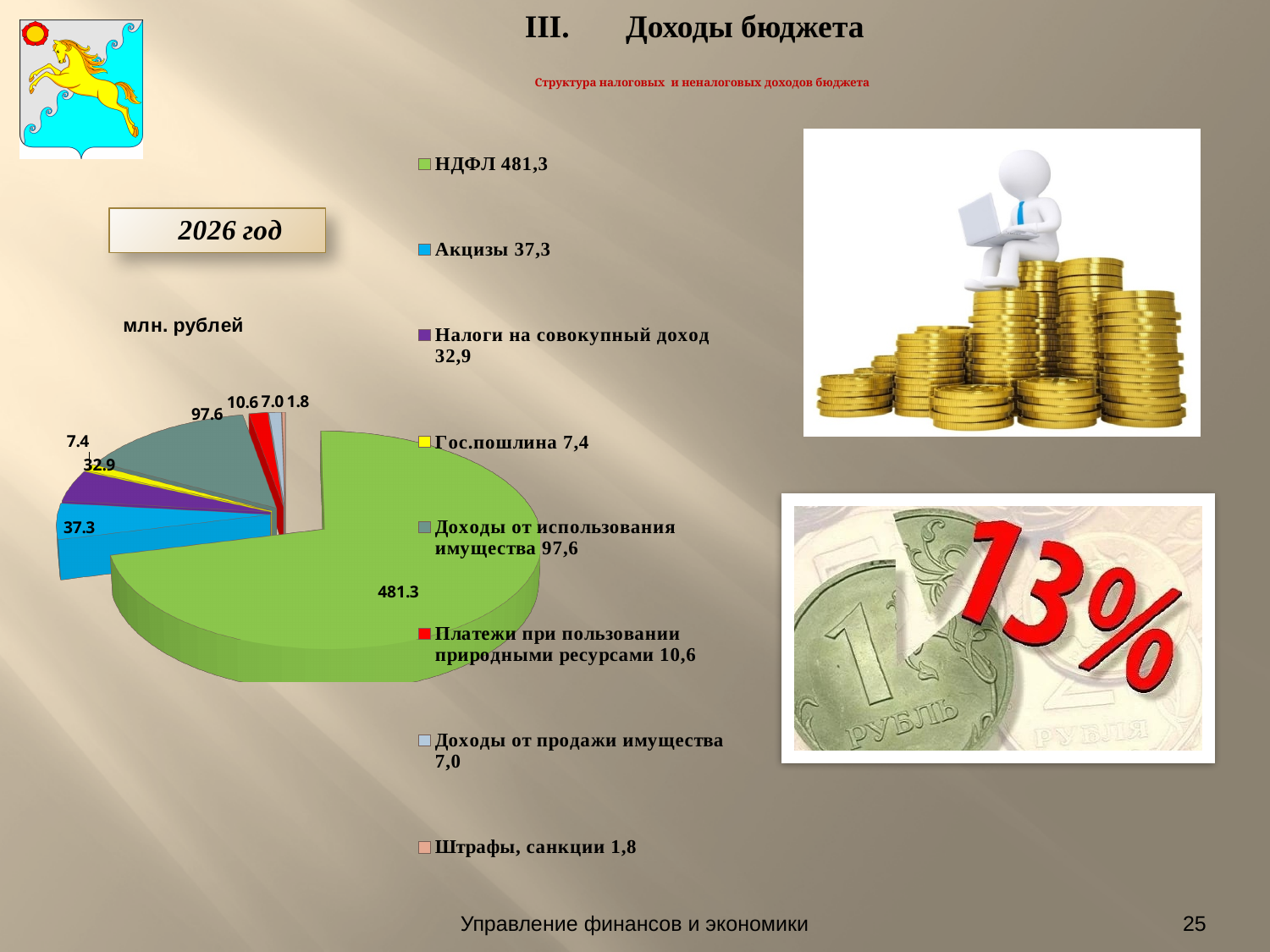
What is the value for НДФЛ in the pie chart? 481.3 What is the value for Штрафы, санкции in the pie chart? 1.8 What is the value for Доходы от использования имущества in the pie chart? 97.6 How many categories does the pie chart show? 8 What is the value for Акцизы in the pie chart? 37.3 What is the difference between the values for НДФЛ and Доходы от использования имущества? 383.7 What type of chart is shown on the slide? Pie chart What is the difference between the values for Акцизы and Налоги на совокупный доход? 4.4 Which category has the smallest slice in the pie chart? Штрафы, санкции Which category has the largest slice in the pie chart? НДФЛ Which is larger in the pie chart: Акцизы or Налоги на совокупный доход? Акцизы In what units are the values of the pie chart given? млн. рублей